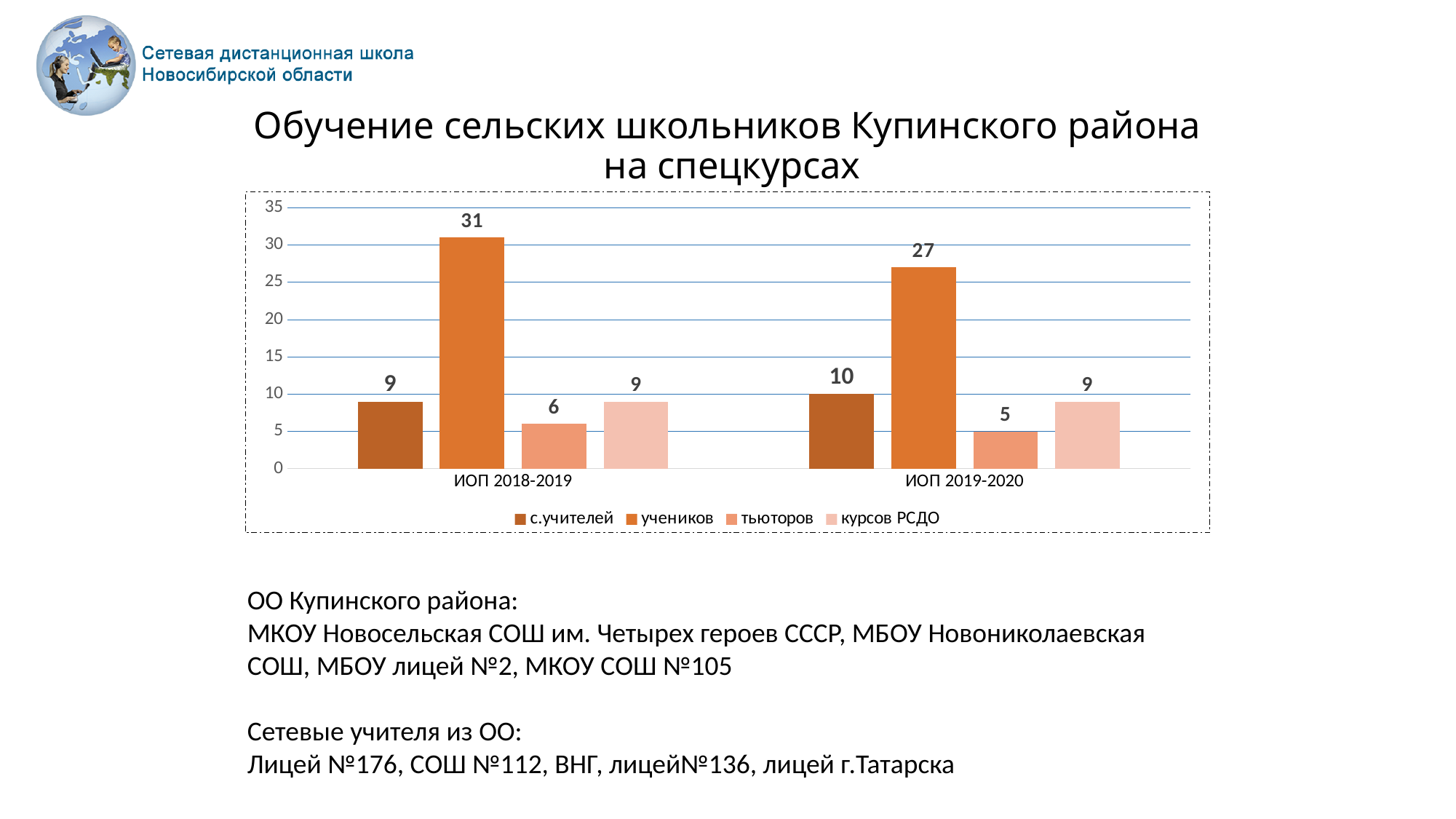
What is the value for с.учителей in ИОП 2019-2020? 10 What is the value for курсов РСДО in ИОП 2018-2019? 9 How many categories are shown on the x axis? 2 Which series has the lowest value in ИОП 2018-2019? тьюторов What kind of chart is shown on the slide? bar chart Which is larger: с.учителей in ИОП 2018-2019 or с.учителей in ИОП 2019-2020? ИОП 2019-2020 Does the value for учеников rise or fall from ИОП 2018-2019 to ИОП 2019-2020? fall What is the value for учеников in ИОП 2018-2019? 31 Which series has the highest value in ИОП 2019-2020? учеников How many series does the legend list? 4 What is the value for тьюторов in ИОП 2019-2020? 5 What is the difference between the учеников values for ИОП 2018-2019 and ИОП 2019-2020? 4